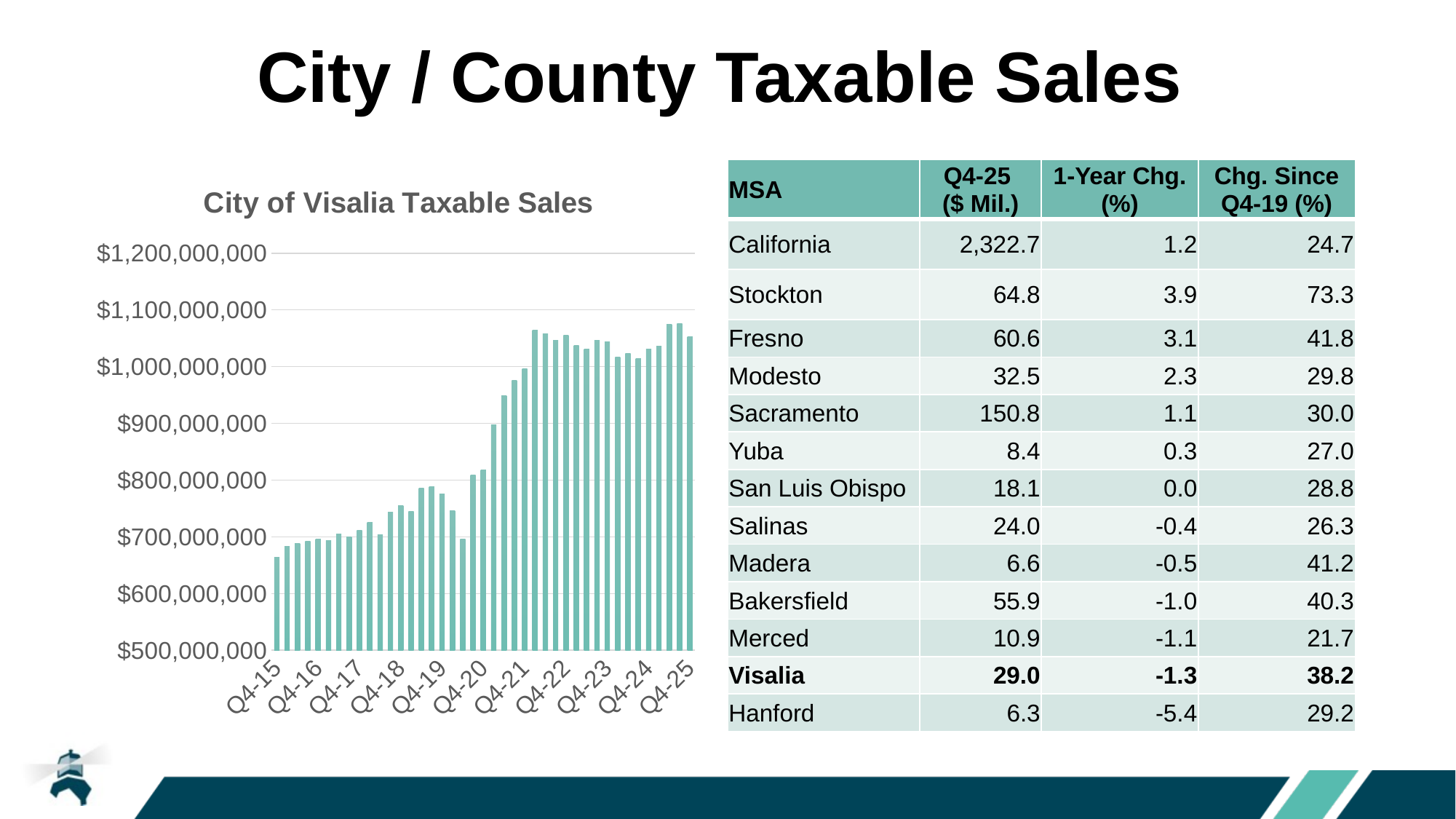
Is the value for Q4-19 greater or less than $700,000,000? greater Is the value for Q4-25 greater or less than $1,000,000,000? greater Is the value for Q4-15 greater or less than $700,000,000? less What is the title of the chart? City of Visalia Taxable Sales What is the highest value shown on the y axis of the chart? $1,200,000,000 Overall, do the values rise or fall from Q4-15 to Q4-25? Rise Which is larger, the value for Q4-21 or the value for Q4-15? Q4-21 What kind of chart is shown on the slide? Bar chart Which is larger, the value for Q4-19 or the value for Q4-16? Q4-19 How many quarter labels are shown on the x axis of the chart? 11